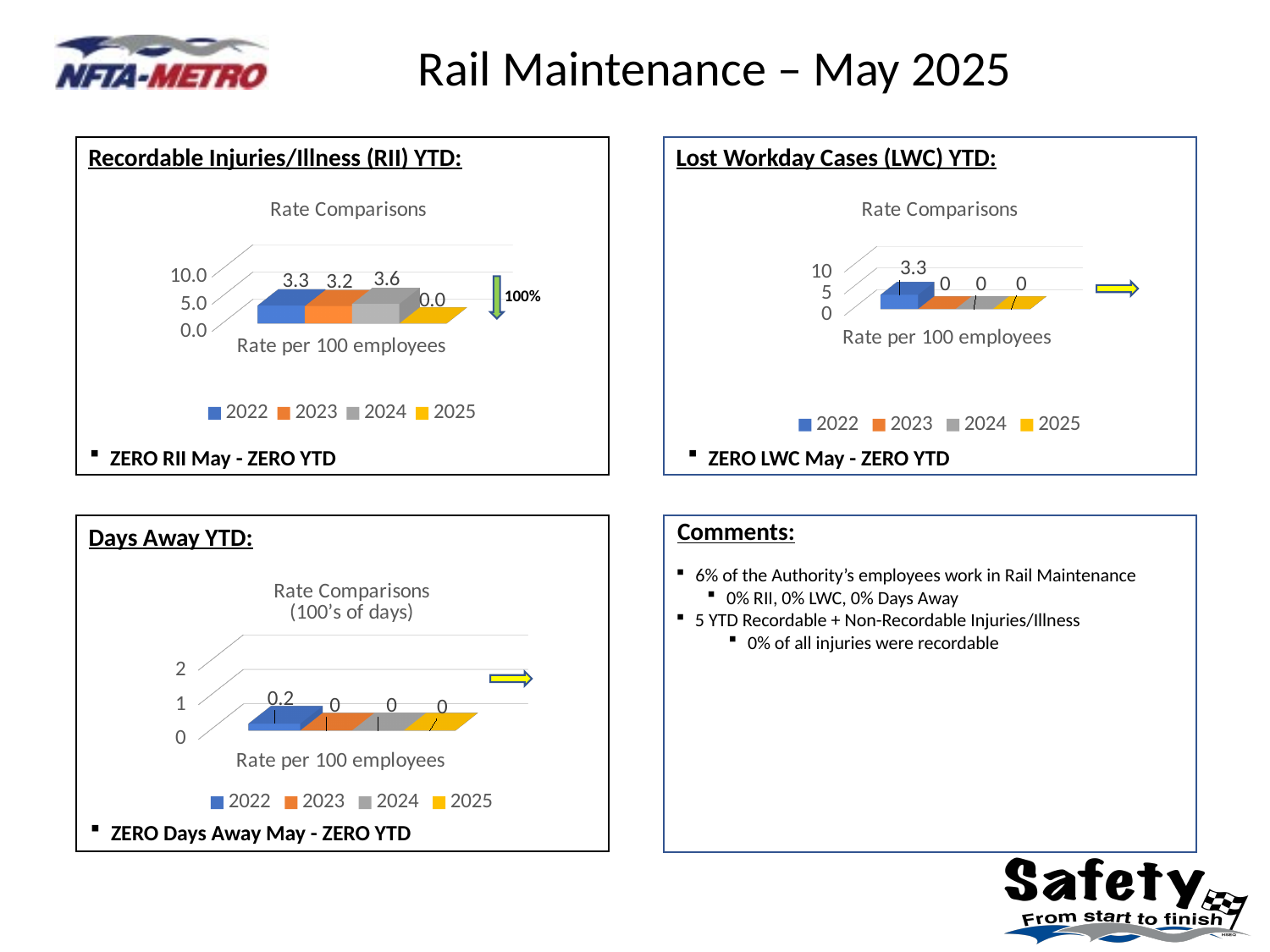
How many series does the legend of the Lost Workday Cases (LWC) YTD chart list? 4 In the Lost Workday Cases (LWC) YTD chart, what is the value for 2025? 0 What is the subtitle shown under the title of the Days Away YTD chart? (100's of days) In the Recordable Injuries/Illness (RII) YTD chart, which year has the highest rate? 2024 What kind of chart is the Days Away YTD chart? bar chart In the Recordable Injuries/Illness (RII) YTD chart, what is the value for 2024? 3.6 In the Recordable Injuries/Illness (RII) YTD chart, what is the difference between the 2024 and 2023 values? 0.4 In the Recordable Injuries/Illness (RII) YTD chart, what is the value for 2025? 0.0 In the Lost Workday Cases (LWC) YTD chart, what is the value for 2022? 3.3 In the Recordable Injuries/Illness (RII) YTD chart, which is larger, the value for 2022 or the value for 2023? 2022 In the Days Away YTD chart, what is the value for 2022? 0.2 In the Days Away YTD chart, which year has the highest value? 2022